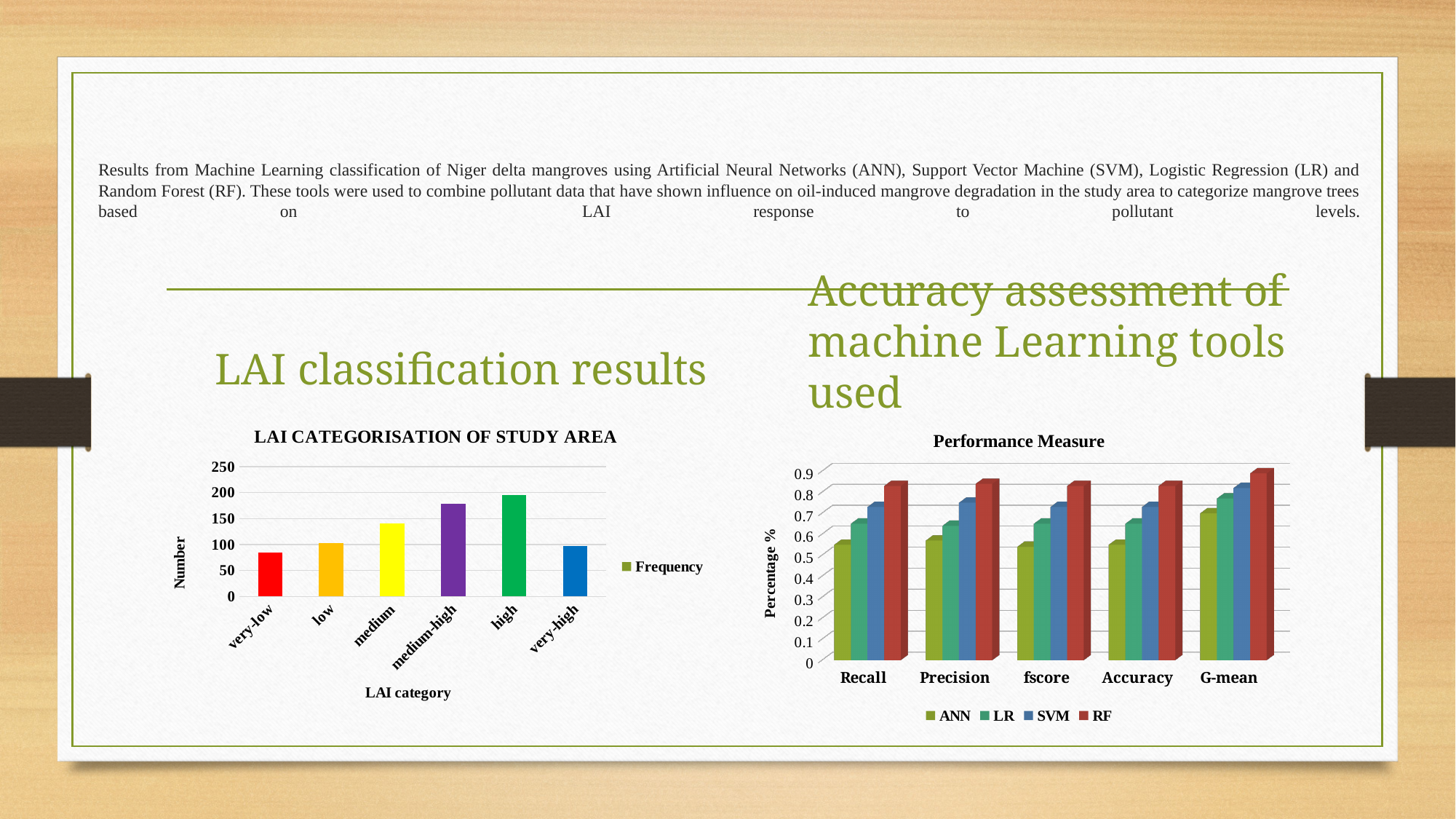
What kind of chart is the 'LAI CATEGORISATION OF STUDY AREA' chart? bar chart In the 'LAI CATEGORISATION OF STUDY AREA' chart, is the value for very-low greater or less than 100? less In the 'LAI CATEGORISATION OF STUDY AREA' chart, is the value for medium greater or less than 100? greater How many LAI categories are shown on the x axis of the 'LAI CATEGORISATION OF STUDY AREA' chart? 6 How many performance measures are shown on the x axis of the 'Performance Measure' chart? 5 In the 'LAI CATEGORISATION OF STUDY AREA' chart, which LAI category has the highest frequency? high In the 'LAI CATEGORISATION OF STUDY AREA' chart, is the value for high greater or less than 150? greater In the 'Performance Measure' chart, which series has the highest value for Recall? RF What is the y-axis title of the 'Performance Measure' chart? Percentage % How many series does the legend of the 'Performance Measure' chart list? 4 In the 'LAI CATEGORISATION OF STUDY AREA' chart, which is larger, the value for medium-high or the value for low? medium-high